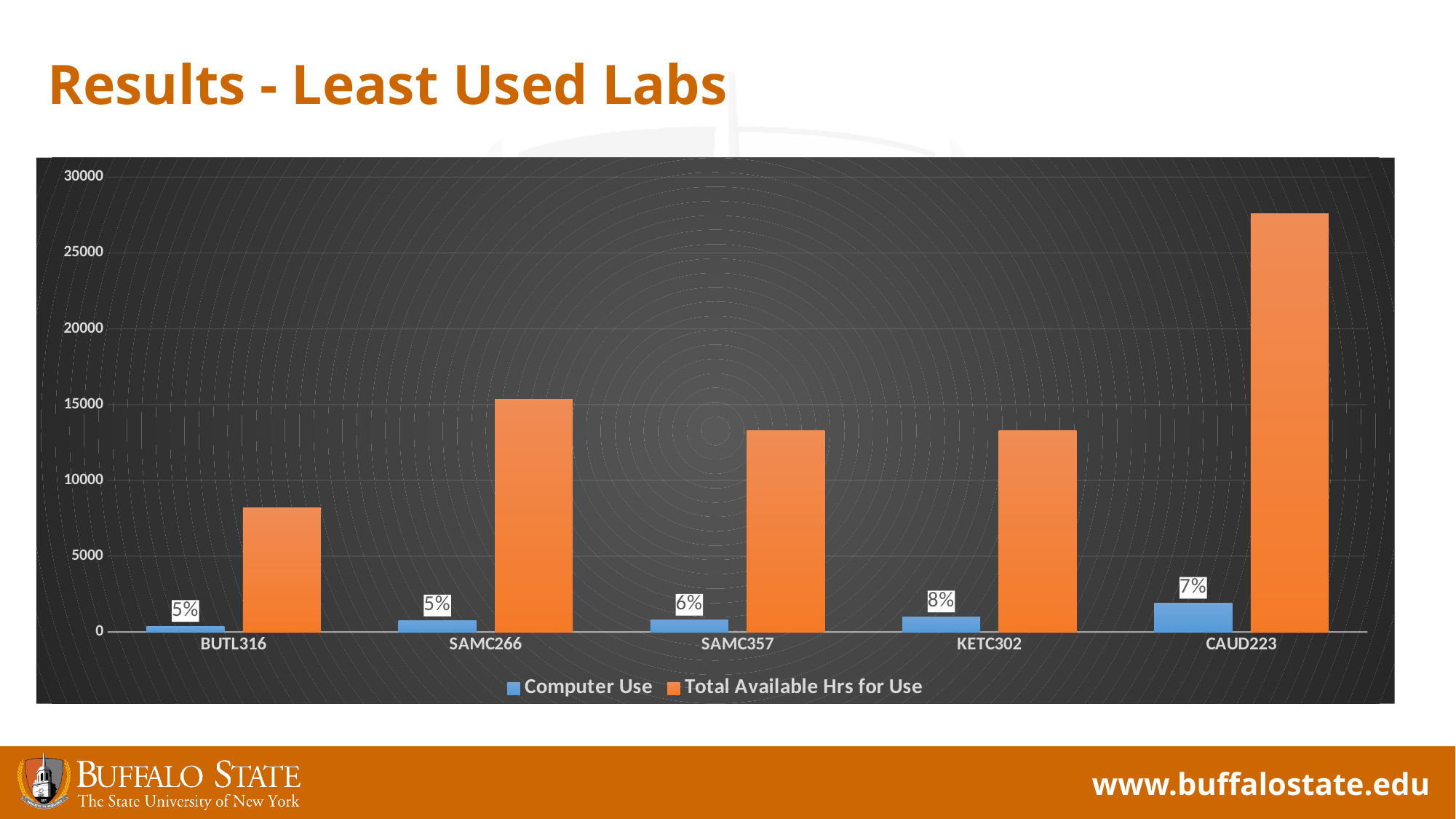
Is the Total Available Hrs for Use value for CAUD223 greater or less than 25000? greater Which lab has the highest Total Available Hrs for Use? CAUD223 What percentage label is shown above the Computer Use bar for CAUD223? 7% How many series does the chart legend list? 2 How many labs are shown on the x axis of the chart? 5 What percentage label is shown above the Computer Use bar for SAMC357? 6% What is the title of the slide containing the chart? Results - Least Used Labs What percentage label is shown above the Computer Use bar for KETC302? 8% What kind of chart is shown on the slide? bar chart Is the Total Available Hrs for Use value for BUTL316 greater or less than 10000? less Which lab has the lowest Total Available Hrs for Use? BUTL316 Which is larger, the Total Available Hrs for Use for SAMC266 or for SAMC357? SAMC266